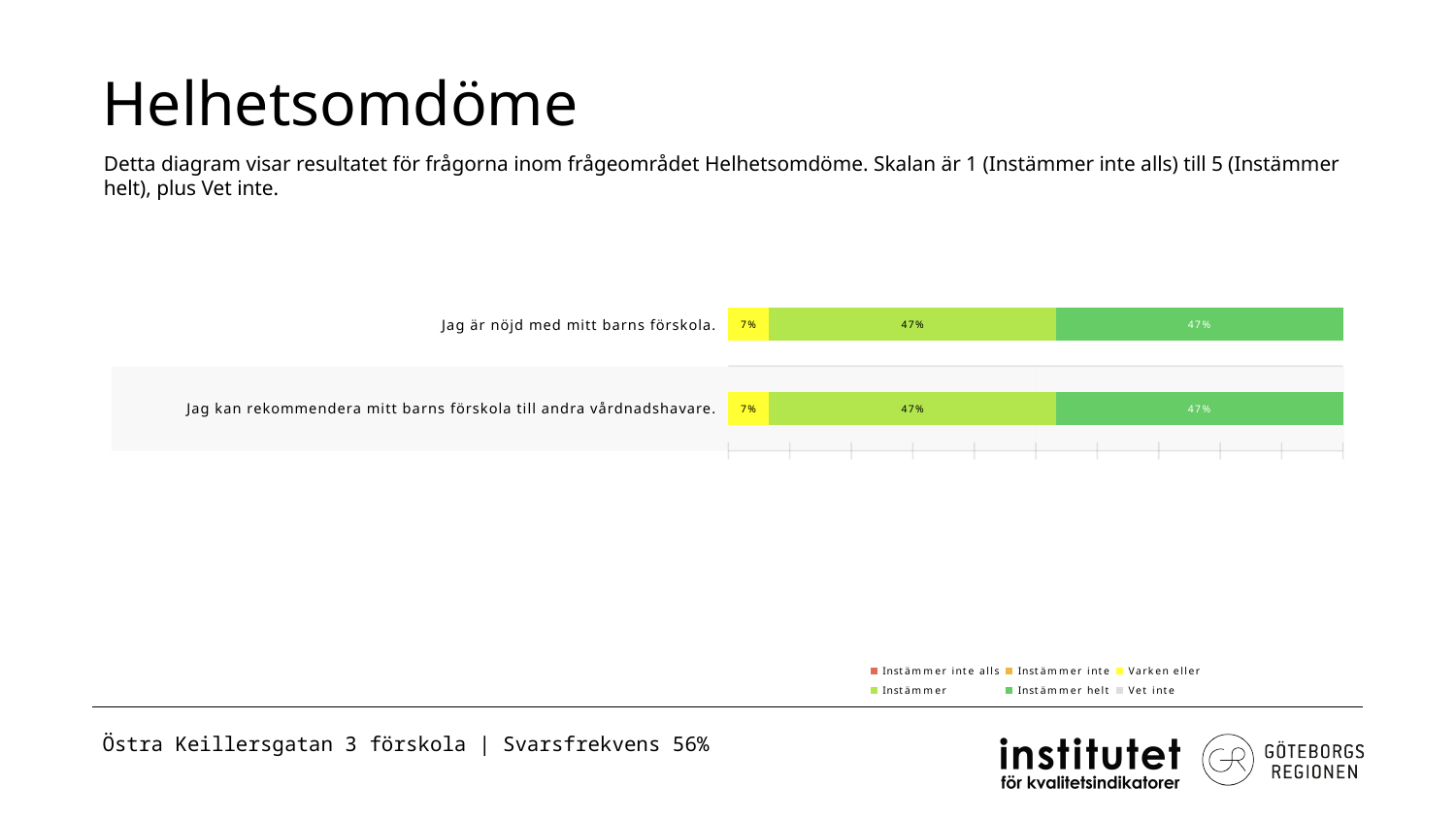
Which legend entry is shown in yellow? Varken eller Which segment is the smallest in the bar for "Jag kan rekommendera mitt barns förskola till andra vårdnadshavare."? Varken eller (7%) What is the value of the "Instämmer helt" segment for "Jag är nöjd med mitt barns förskola."? 47% What is the title of the slide containing the chart? Helhetsomdöme What is the value of the "Instämmer" segment for "Jag kan rekommendera mitt barns förskola till andra vårdnadshavare."? 47% How many categories (questions) are shown in the chart? 2 What is the difference between the "Instämmer" and "Varken eller" segments for "Jag är nöjd med mitt barns förskola."? 40% How many series does the legend list? 6 What is the value of the "Varken eller" segment for "Jag kan rekommendera mitt barns förskola till andra vårdnadshavare."? 7% What kind of chart is shown on the slide? Stacked bar chart For "Jag är nöjd med mitt barns förskola.", which is larger: the "Varken eller" segment or the "Instämmer helt" segment? Instämmer helt What is the total of the labelled segments for "Jag är nöjd med mitt barns förskola."? 101%